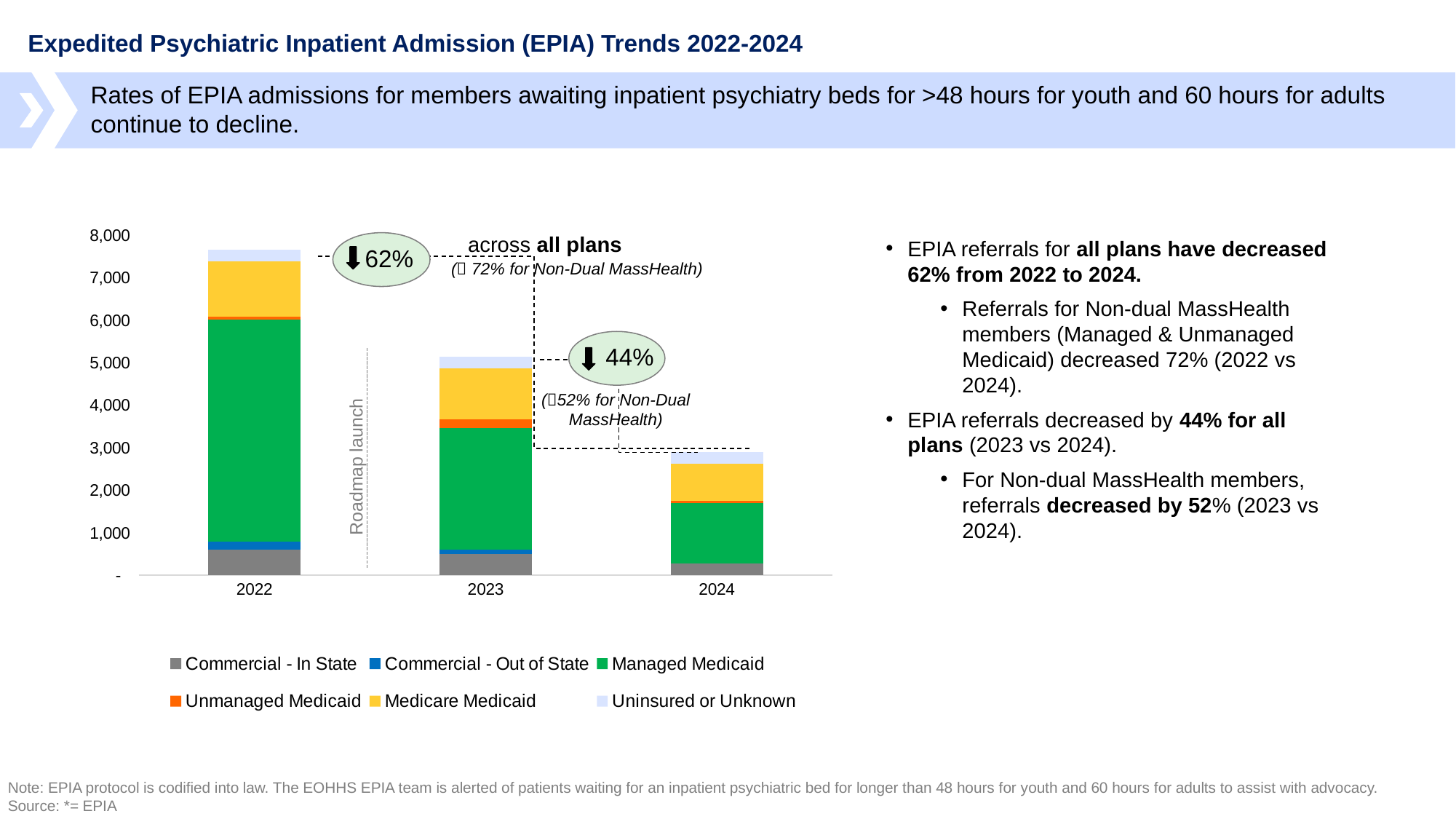
Which year has the shortest stacked bar in the chart? 2024 Is the total stacked bar for 2023 greater or less than 4,000? greater According to the annotation on the chart, by what percentage did EPIA referrals across all plans decrease from 2023 to 2024? 44% How many years (categories) are shown on the x axis of the chart? 3 What kind of chart is shown on the slide? Stacked bar chart Do the total EPIA referrals rise or fall from 2022 to 2024 in the chart? Fall Is the total stacked bar for 2024 greater or less than 4,000? less Which year has the tallest stacked bar in the chart? 2022 How many series does the chart legend list? 6 According to the annotation on the chart, by what percentage did EPIA referrals across all plans decrease from 2022 to 2024? 62% Is the total stacked bar for 2022 greater or less than 7,000? greater Which series in the chart legend is shown in green? Managed Medicaid